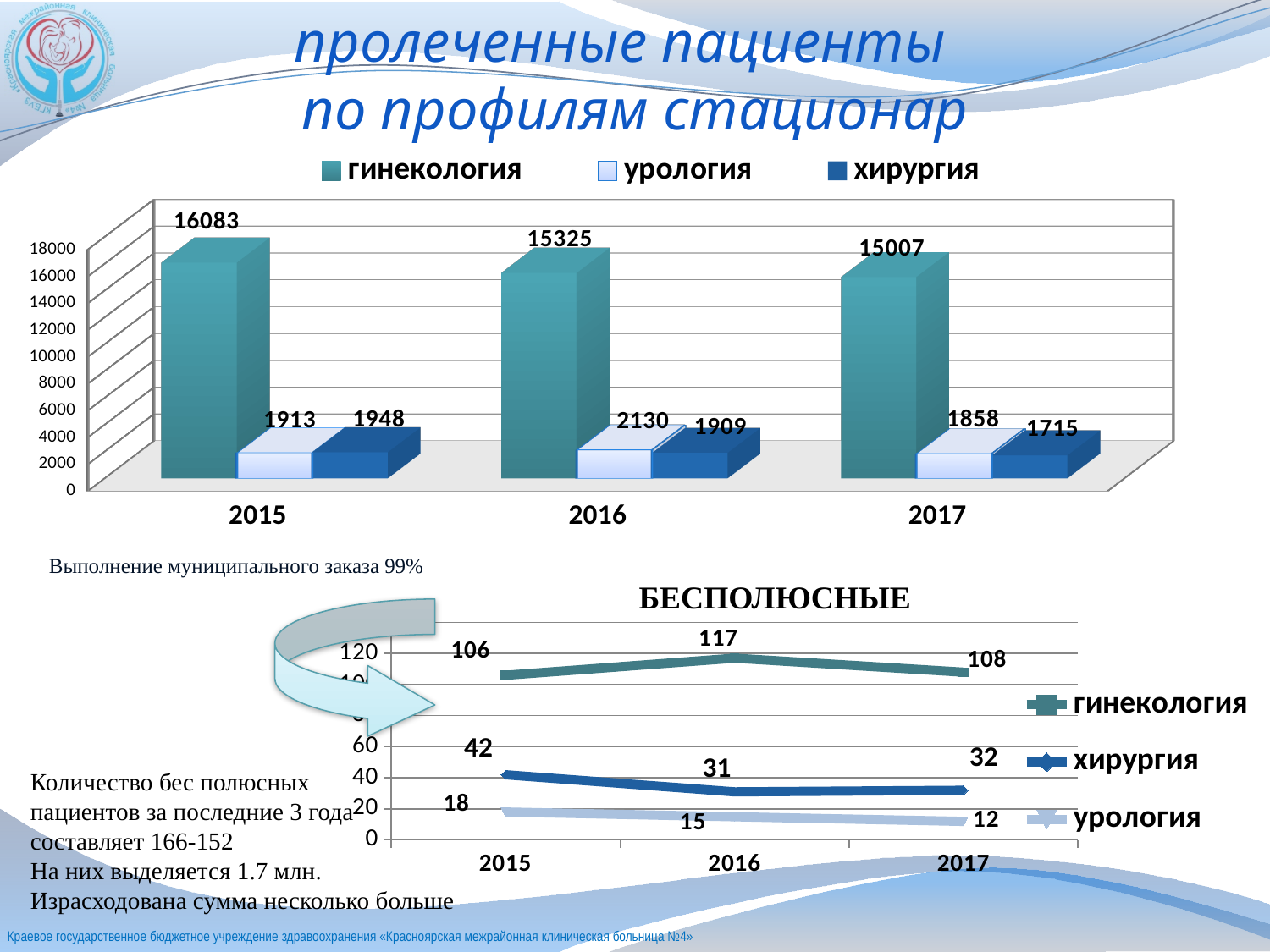
In the БЕСПОЛЮСНЫЕ chart, what is the value for хирургия in 2015? 42 In the top bar chart, how many series does the legend list? 3 What kind of chart is the БЕСПОЛЮСНЫЕ chart? line chart In the top bar chart, which is larger in 2016: урология or хирургия? урология In the top bar chart, what is the difference between the гинекология values for 2015 and 2017? 1076 In the БЕСПОЛЮСНЫЕ chart, does the урология series rise or fall from 2015 to 2017? fall What kind of chart is the top chart? bar chart In the top bar chart, what is the value for гинекология in 2015? 16083 In the top bar chart, which year has the highest value for гинекология? 2015 In the top bar chart, what is the value for урология in 2016? 2130 In the БЕСПОЛЮСНЫЕ chart, what is the value for гинекология in 2016? 117 In the top bar chart, what is the value for хирургия in 2017? 1715